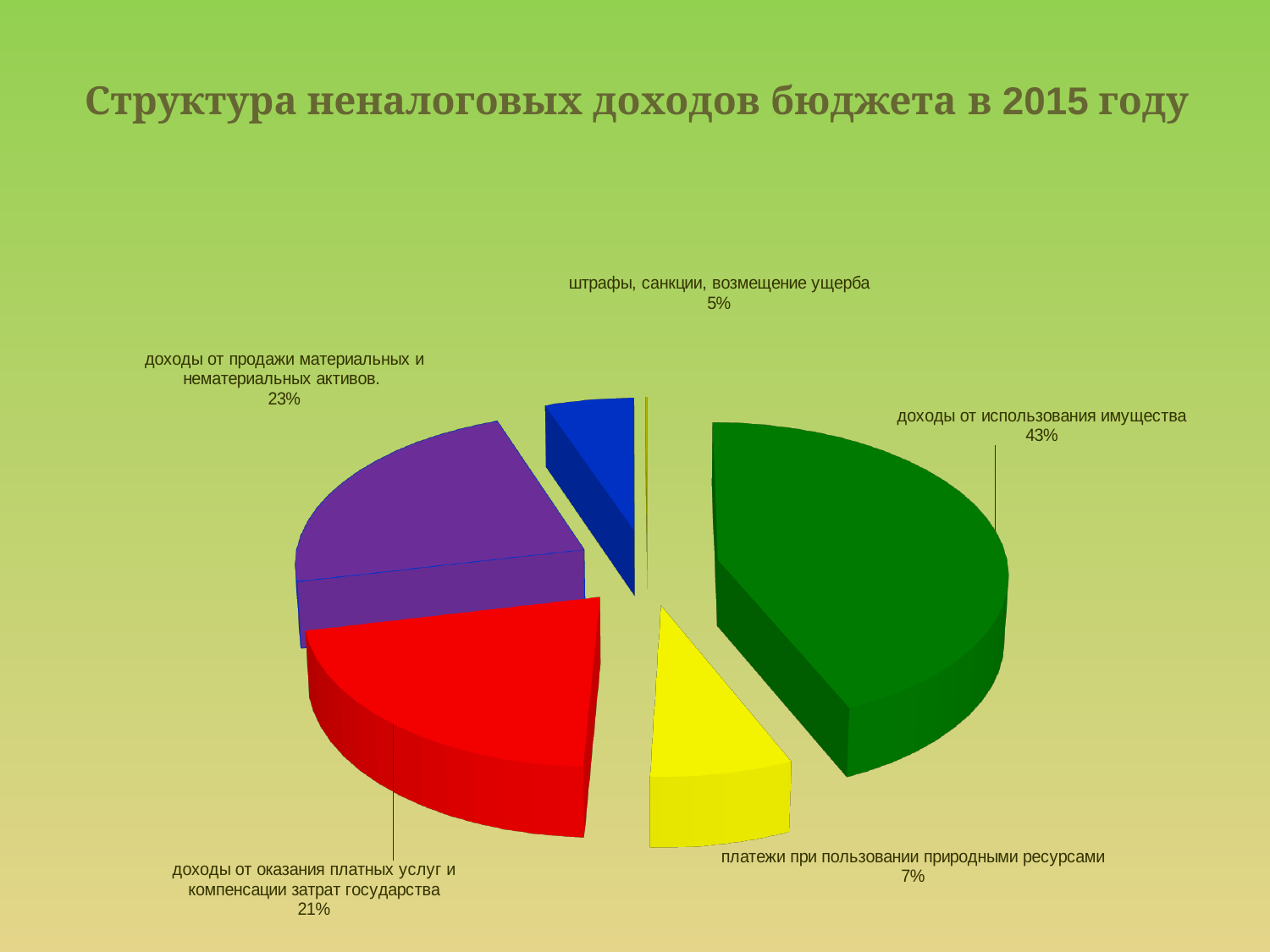
How many slices does the pie chart have? 5 What share of the pie is "штрафы, санкции, возмещение ущерба"? 5% What is the title of the chart? Структура неналоговых доходов бюджета в 2015 году What is the difference in percentage points between "доходы от использования имущества" and "доходы от продажи материальных и нематериальных активов"? 20% What share of the pie is "платежи при пользовании природными ресурсами"? 7% Which category has the largest share of the pie? доходы от использования имущества What share of the pie is "доходы от продажи материальных и нематериальных активов"? 23% What type of chart is shown on the slide? Pie chart Which category has the smallest share of the pie? штрафы, санкции, возмещение ущерба Which is larger: the share for "платежи при пользовании природными ресурсами" or the share for "штрафы, санкции, возмещение ущерба"? платежи при пользовании природными ресурсами